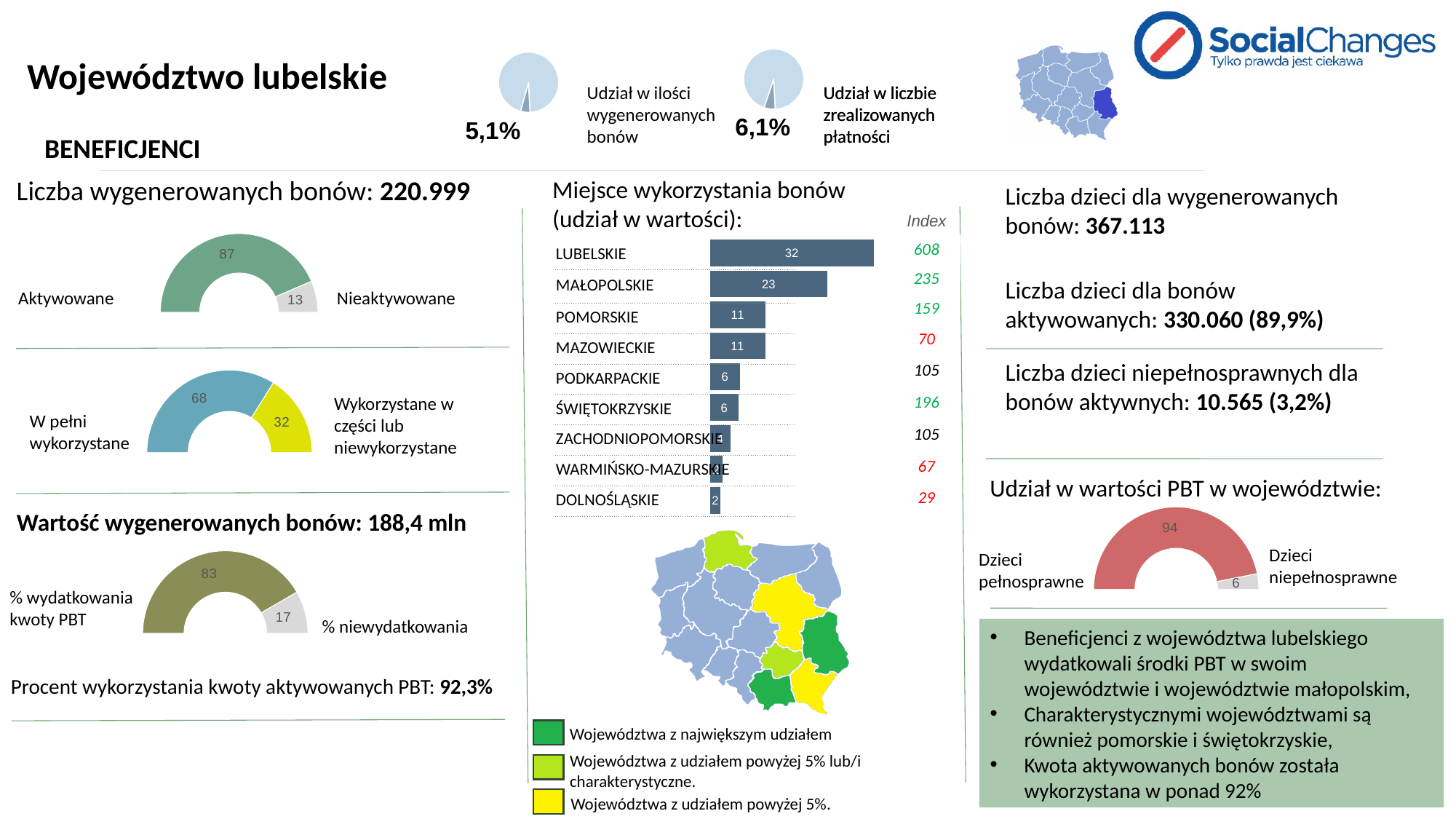
In the 'Miejsce wykorzystania bonów (udział w wartości)' bar chart, what is the value for MAŁOPOLSKIE? 23 In the 'Miejsce wykorzystania bonów (udział w wartości)' bar chart, what is the Index value shown for LUBELSKIE? 608 In the half-donut chart under 'Liczba wygenerowanych bonów', what is the value for Aktywowane? 87 In the 'Miejsce wykorzystania bonów (udział w wartości)' bar chart, how many regions are listed? 9 In the 'Miejsce wykorzystania bonów (udział w wartości)' bar chart, which is larger: the value for POMORSKIE or the value for PODKARPACKIE? POMORSKIE In the half-donut chart showing 'W pełni wykorzystane' and 'Wykorzystane w części lub niewykorzystane', what is the value for W pełni wykorzystane? 68 In the 'Miejsce wykorzystania bonów (udział w wartości)' bar chart, what is the value for LUBELSKIE? 32 In the half-donut chart under 'Udział w wartości PBT w województwie', what is the value for Dzieci niepełnosprawne? 6 In the half-donut chart under 'Wartość wygenerowanych bonów', what is the value for '% niewydatkowania'? 17 What kind of chart is 'Miejsce wykorzystania bonów (udział w wartości)'? bar chart In the 'Miejsce wykorzystania bonów (udział w wartości)' bar chart, which region has the highest value? LUBELSKIE In the 'Miejsce wykorzystania bonów (udział w wartości)' bar chart, what is the difference between the values for LUBELSKIE and MAŁOPOLSKIE? 9